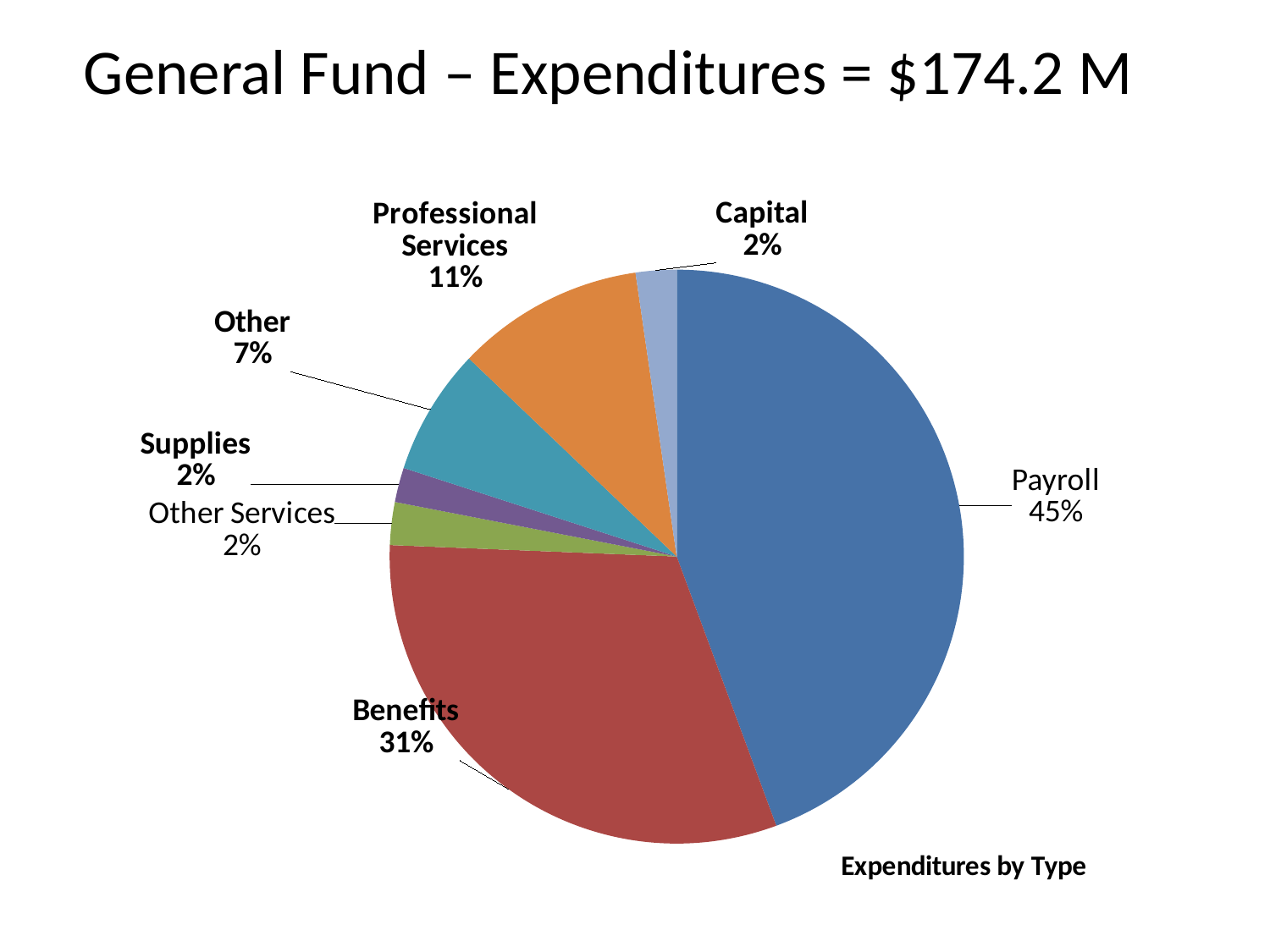
What share of expenditures is Professional Services? 11% What is the difference in percentage points between the Payroll share and the Benefits share? 14% What is the total General Fund expenditure stated in the slide title? $174.2 M What share of expenditures is Benefits? 31% How many slices does the pie chart have? 7 What is the title of the chart? Expenditures by Type What share of expenditures is Payroll? 45% What kind of chart is shown on the slide? pie chart Which is larger, the share for Benefits or the share for Professional Services? Benefits Which category has the largest share of expenditures? Payroll